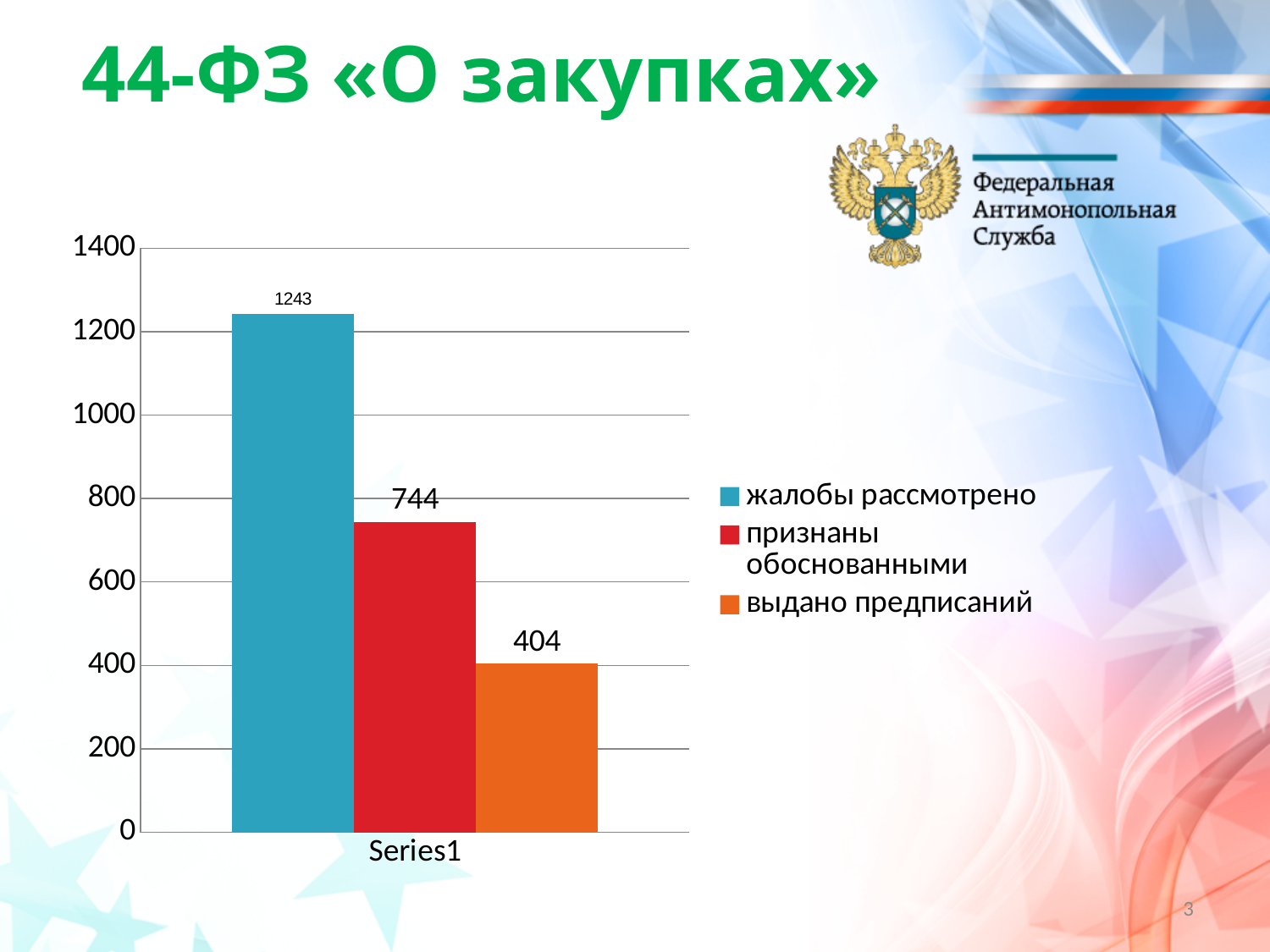
What is the difference between "признаны обоснованными" and "выдано предписаний"? 340 Which series has the highest value? жалобы рассмотрено What is the value for "выдано предписаний"? 404 What is the value for "жалобы рассмотрено"? 1243 Which series has the lowest value? выдано предписаний Which is larger: "признаны обоснованными" or "выдано предписаний"? признаны обоснованными What is the difference between "жалобы рассмотрено" and "признаны обоснованными"? 499 What is the value for "признаны обоснованными"? 744 Is the value for "признаны обоснованными" greater or less than 800? less What colour is the bar for "выдано предписаний"? orange How many series does the legend list? 3 What kind of chart is shown on the slide? bar chart